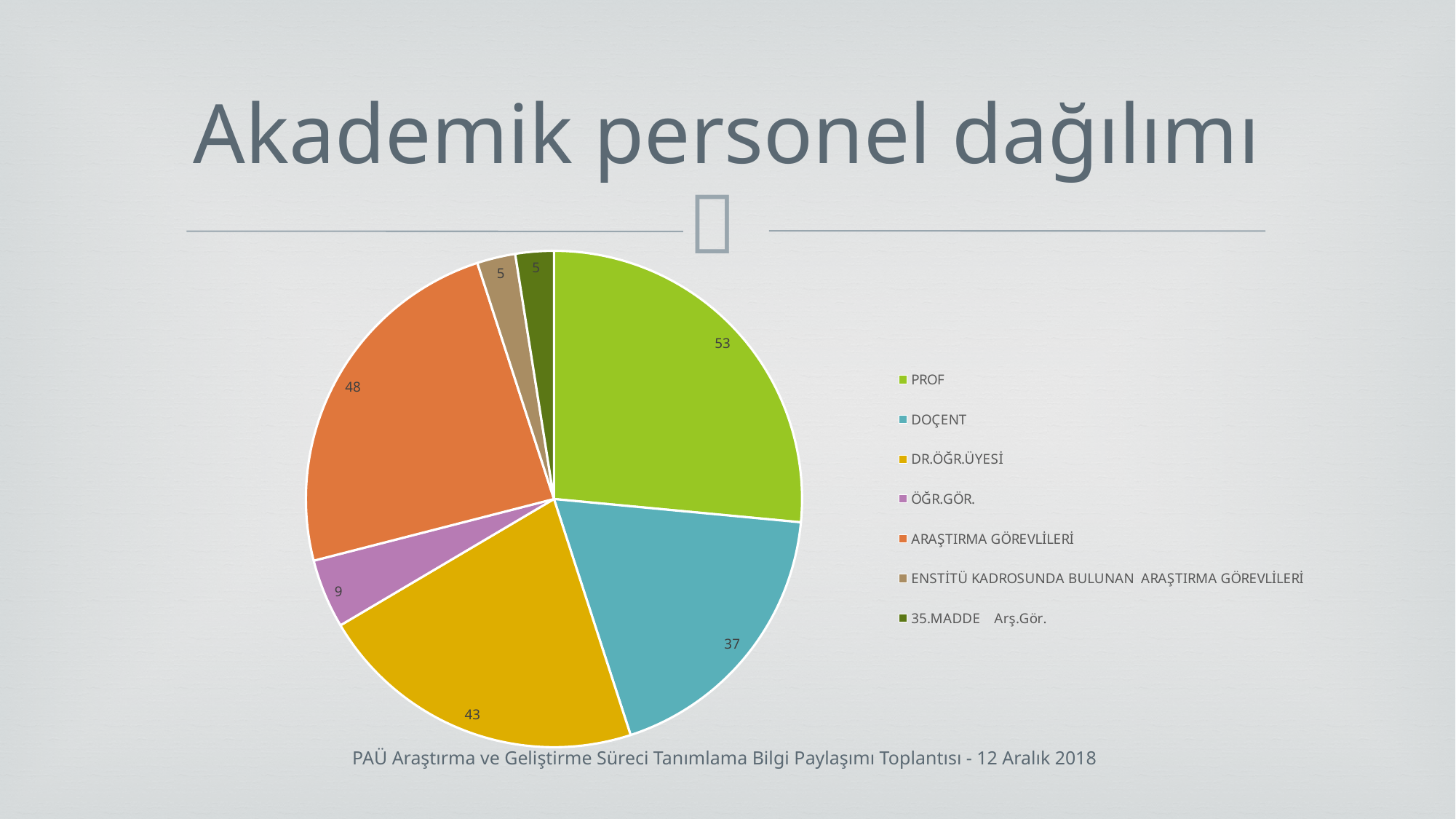
What is the value for ARAŞTIRMA GÖREVLİLERİ in the pie chart? 48 What share of the pie does PROF represent? 26.5% How many categories does the pie chart have? 7 Which category has the largest slice in the pie chart? PROF What kind of chart is shown on the slide? pie chart What is the value for ÖĞR.GÖR. in the pie chart? 9 What is the value for PROF in the pie chart? 53 What is the title of the chart slide? Akademik personel dağılımı What is the value for DOÇENT in the pie chart? 37 What is the difference between the values for PROF and DOÇENT? 16 What is the value for DR.ÖĞR.ÜYESİ in the pie chart? 43 Which is larger, the value for DR.ÖĞR.ÜYESİ or the value for ARAŞTIRMA GÖREVLİLERİ? ARAŞTIRMA GÖREVLİLERİ